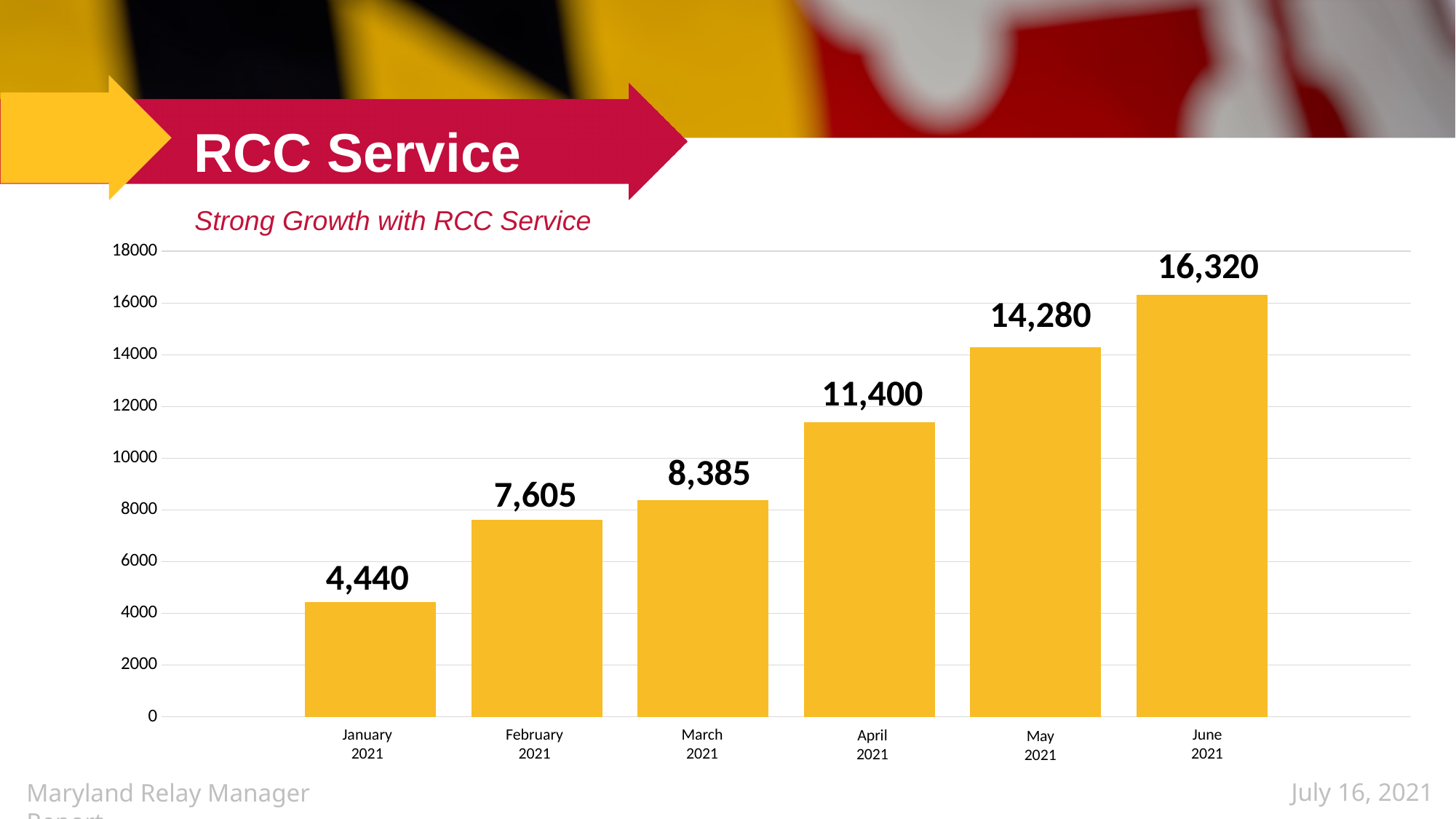
Which is larger, the value for March 2021 or the value for April 2021? April 2021 Which month has the highest value? June 2021 What is the difference between the values for February 2021 and January 2021? 3,165 Is the value for May 2021 greater or less than 14000? greater What kind of chart is shown on the slide? bar chart What is the value for January 2021? 4,440 Do the values rise or fall from January 2021 to June 2021? rise What is the value for June 2021? 16,320 What is the difference between the values for June 2021 and May 2021? 2,040 Which month has the lowest value? January 2021 How many months are shown on the chart? 6 What is the value for April 2021? 11,400